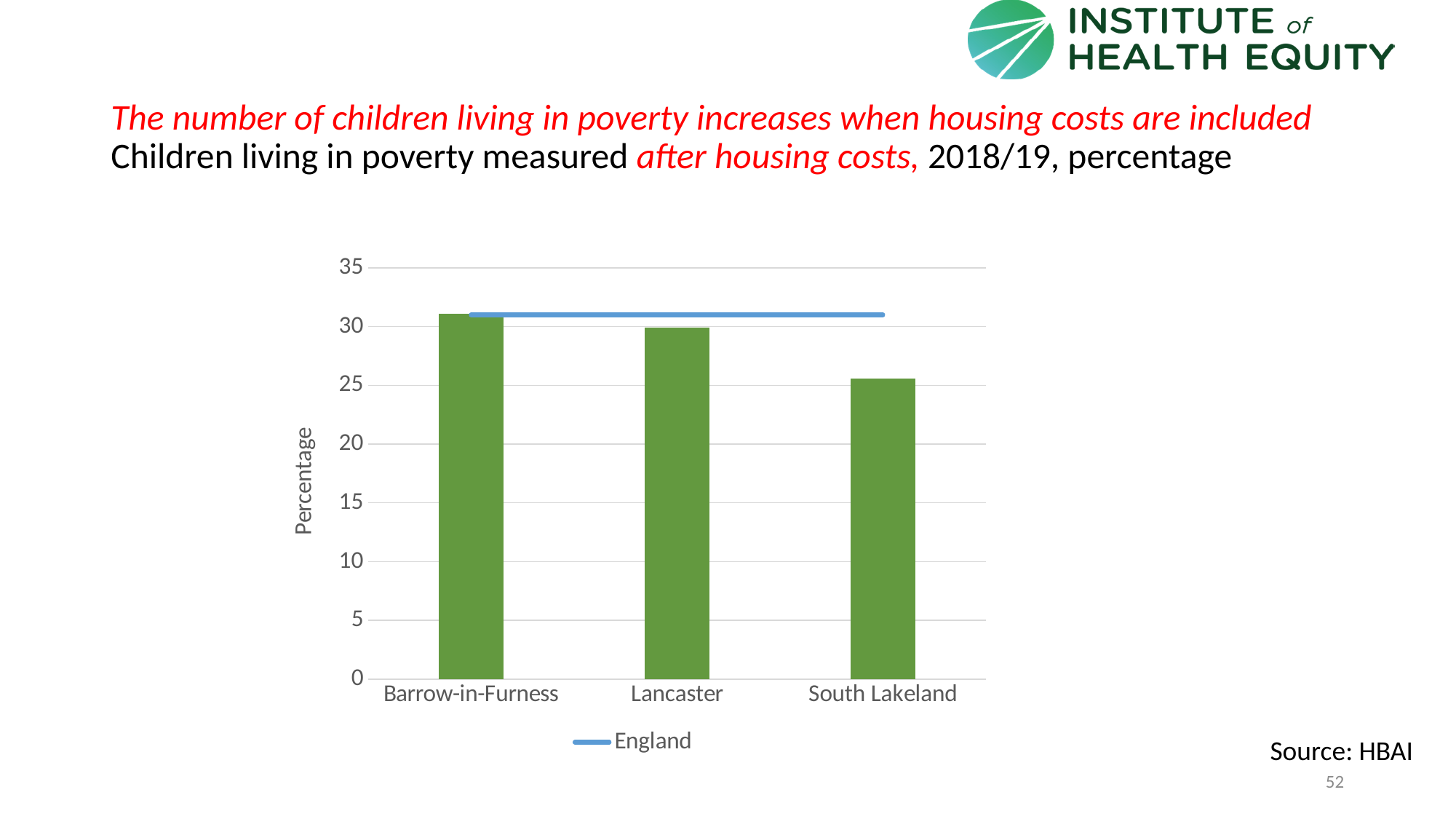
Which is larger, the value for Lancaster or the value for South Lakeland? Lancaster Is the value for South Lakeland greater or less than 30? less Is the value for Barrow-in-Furness greater or less than 25? greater How many local areas are plotted as bars in the chart? 3 Which area has the lowest percentage of children living in poverty after housing costs? South Lakeland Is the value for Lancaster greater or less than 25? greater Do the bar values rise or fall moving from left to right across the chart? fall What kind of chart is shown on the slide? bar chart What is the label on the vertical axis of the chart? Percentage What entry does the chart legend list? England Which area has the highest percentage of children living in poverty after housing costs? Barrow-in-Furness